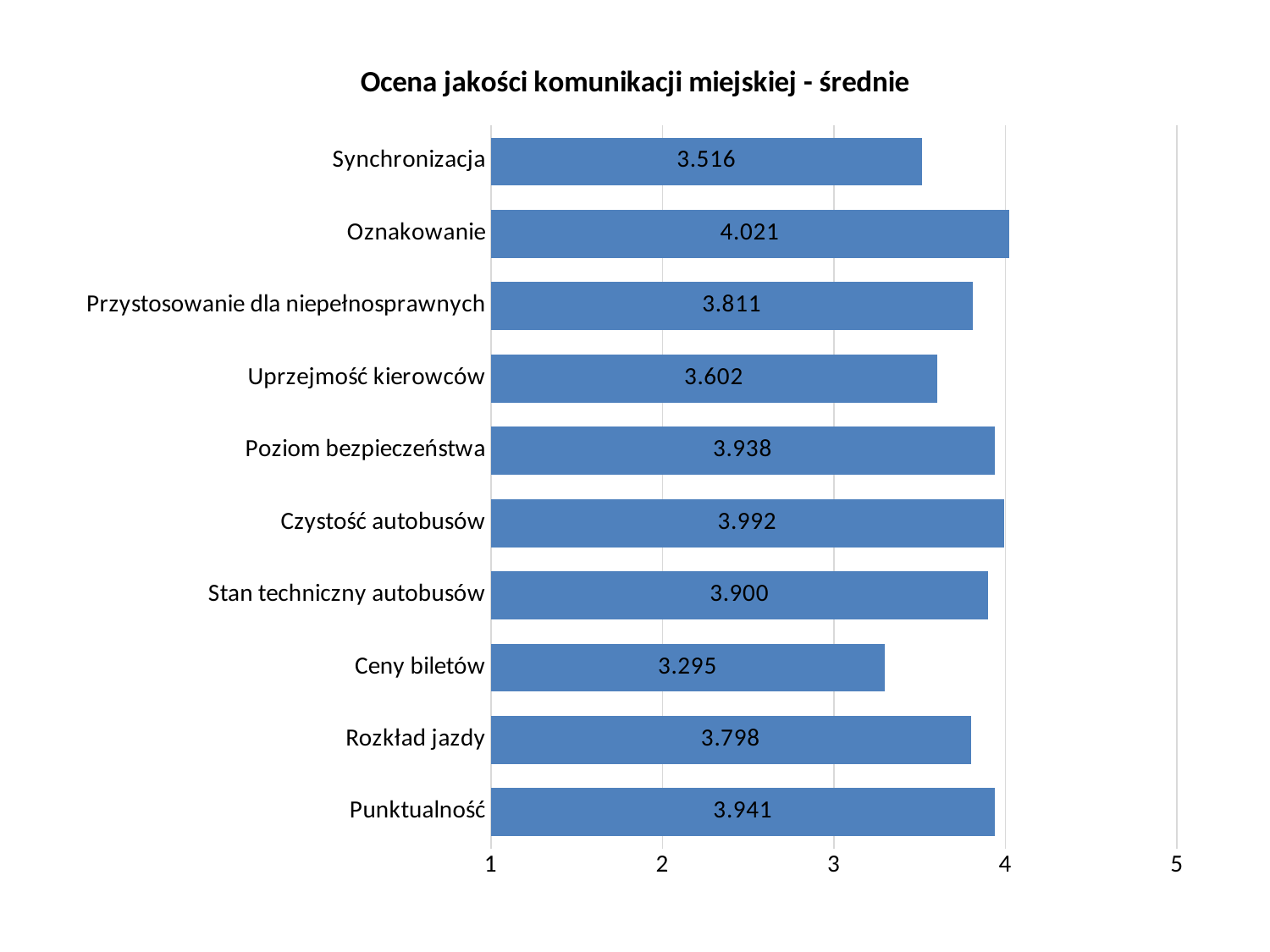
Which category has the lowest value? Ceny biletów What is the difference between the values for Stan techniczny autobusów and Rozkład jazdy? 0.102 What is the difference between the values for Oznakowanie and Ceny biletów? 0.726 What is the value for Ceny biletów? 3.295 What is the value for Punktualność? 3.941 What kind of chart is shown on the slide? bar chart Which category has the highest value? Oznakowanie What is the title of the chart? Ocena jakości komunikacji miejskiej - średnie What is the value for Oznakowanie? 4.021 How many categories are shown in the chart? 10 Which is larger, the value for Synchronizacja or the value for Uprzejmość kierowców? Uprzejmość kierowców Is the value for Czystość autobusów greater or less than 3? greater